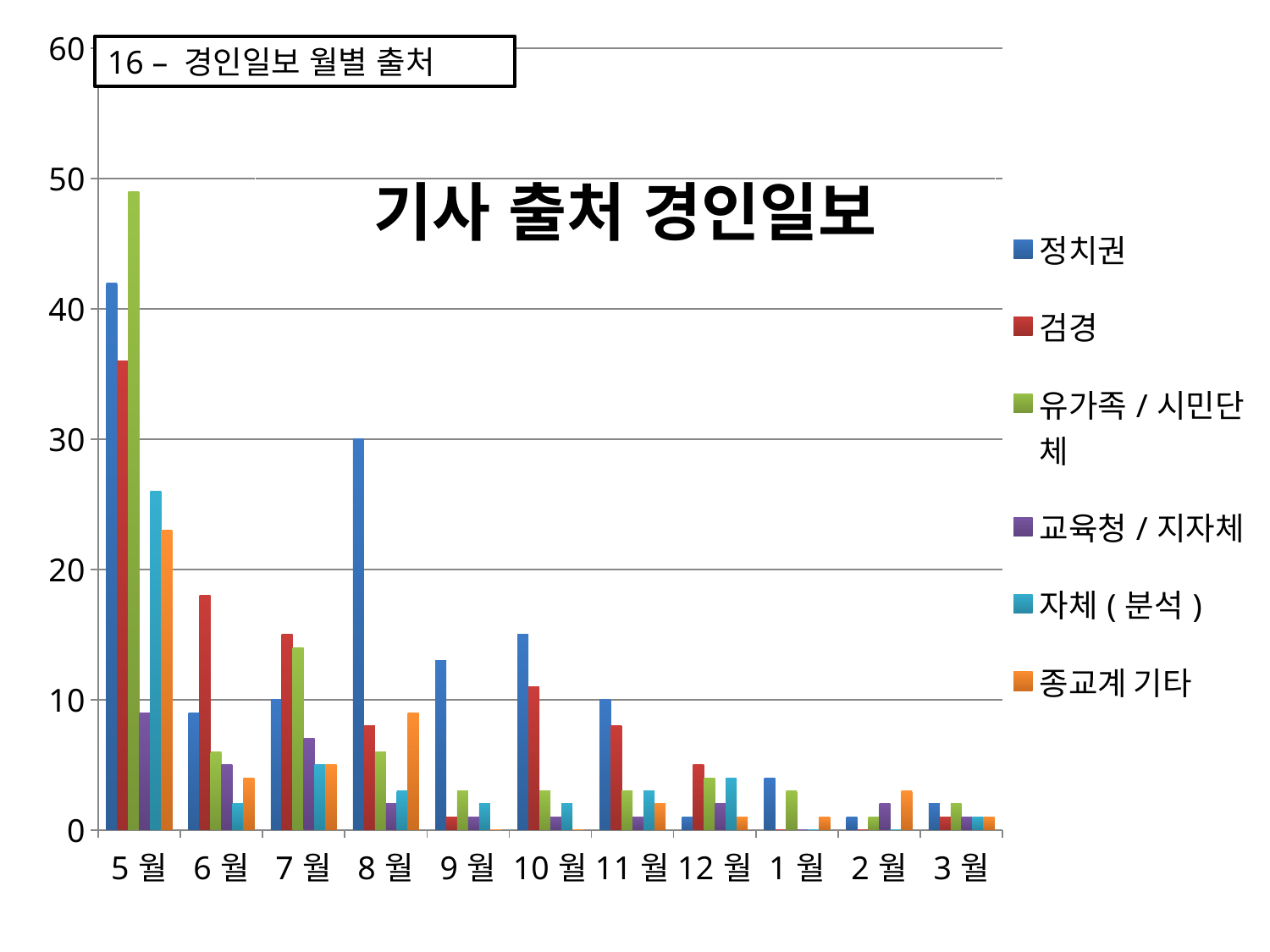
Which is larger in 5 월, 정치권 or 검경? 정치권 Is the value for 검경 in 5 월 greater or less than 30? greater Is the value for 자체 ( 분석 ) in 5 월 greater or less than 20? greater Which series has the tallest bar in 5 월? 유가족 / 시민단체 In which month is the 정치권 bar highest? 5 월 What type of chart is shown on the slide? bar chart Is the value for 유가족 / 시민단체 in 5 월 greater or less than 40? greater How many series does the legend list? 6 How many months are shown on the x axis? 11 What is the value for 정치권 in 7 월? 10 What is the title printed inside the chart area? 기사 출처 경인일보 What is the value for 정치권 in 8 월? 30